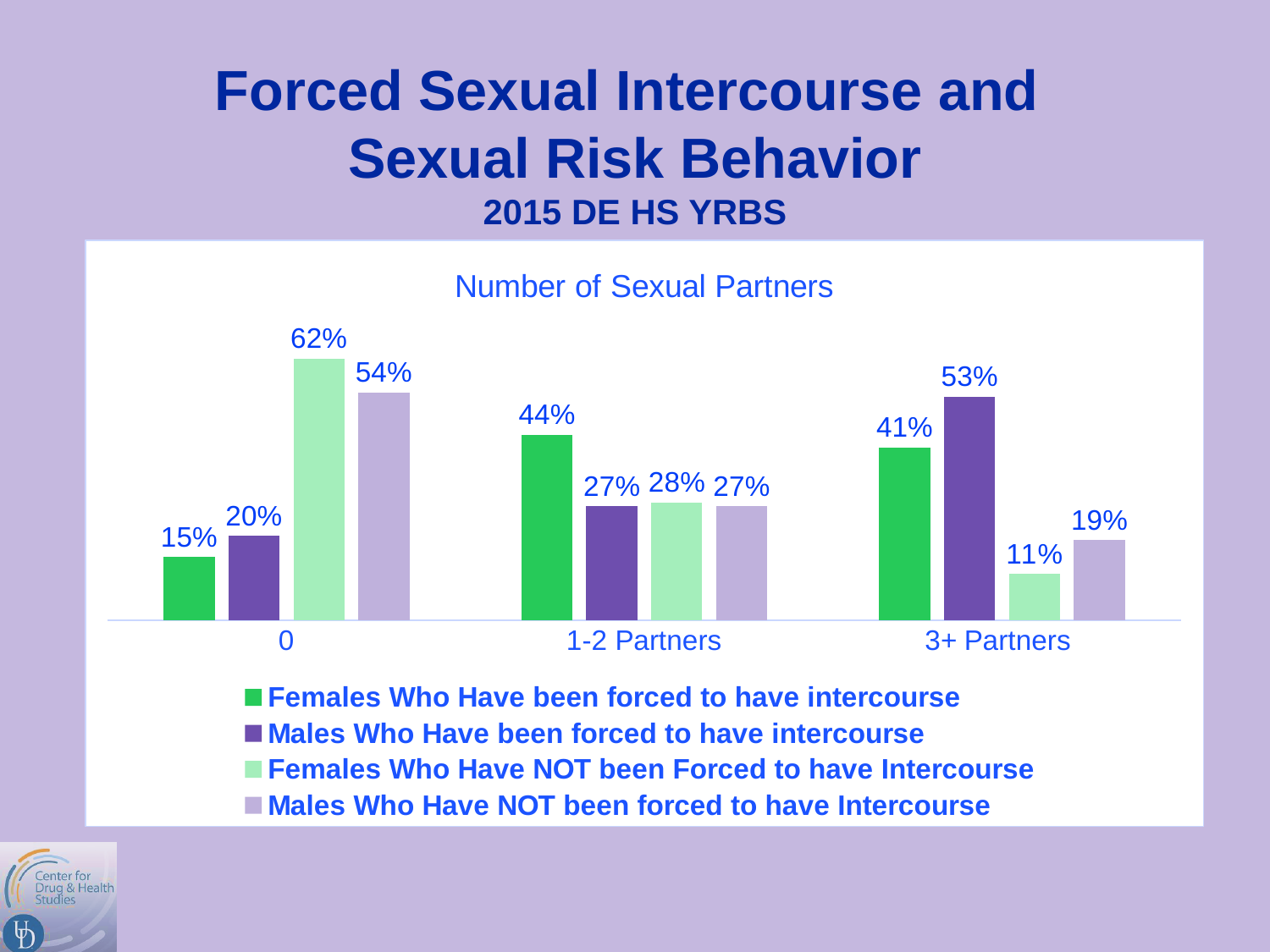
What is the title of the chart? Number of Sexual Partners What is the value for Females Who Have NOT been Forced to have Intercourse in the 1-2 Partners category? 28% What is the difference between the Females Who Have NOT been Forced to have Intercourse value and the Females Who Have been forced to have intercourse value in the 0 partners category? 47% Which series has the lowest value in the 3+ Partners category? Females Who Have NOT been Forced to have Intercourse What is the value for Females Who Have been forced to have intercourse in the 0 partners category? 15% How many series does the legend list? 4 In the 3+ Partners category, which is larger: Males Who Have been forced to have intercourse or Females Who Have been forced to have intercourse? Males Who Have been forced to have intercourse How many categories are shown on the x axis? 3 Do the values for Females Who Have NOT been Forced to have Intercourse rise or fall from 0 to 3+ Partners? Fall What is the value for Males Who Have NOT been forced to have Intercourse in the 3+ Partners category? 19% What kind of chart is shown on the slide? Bar chart Which series has the highest value in the 0 partners category? Females Who Have NOT been Forced to have Intercourse